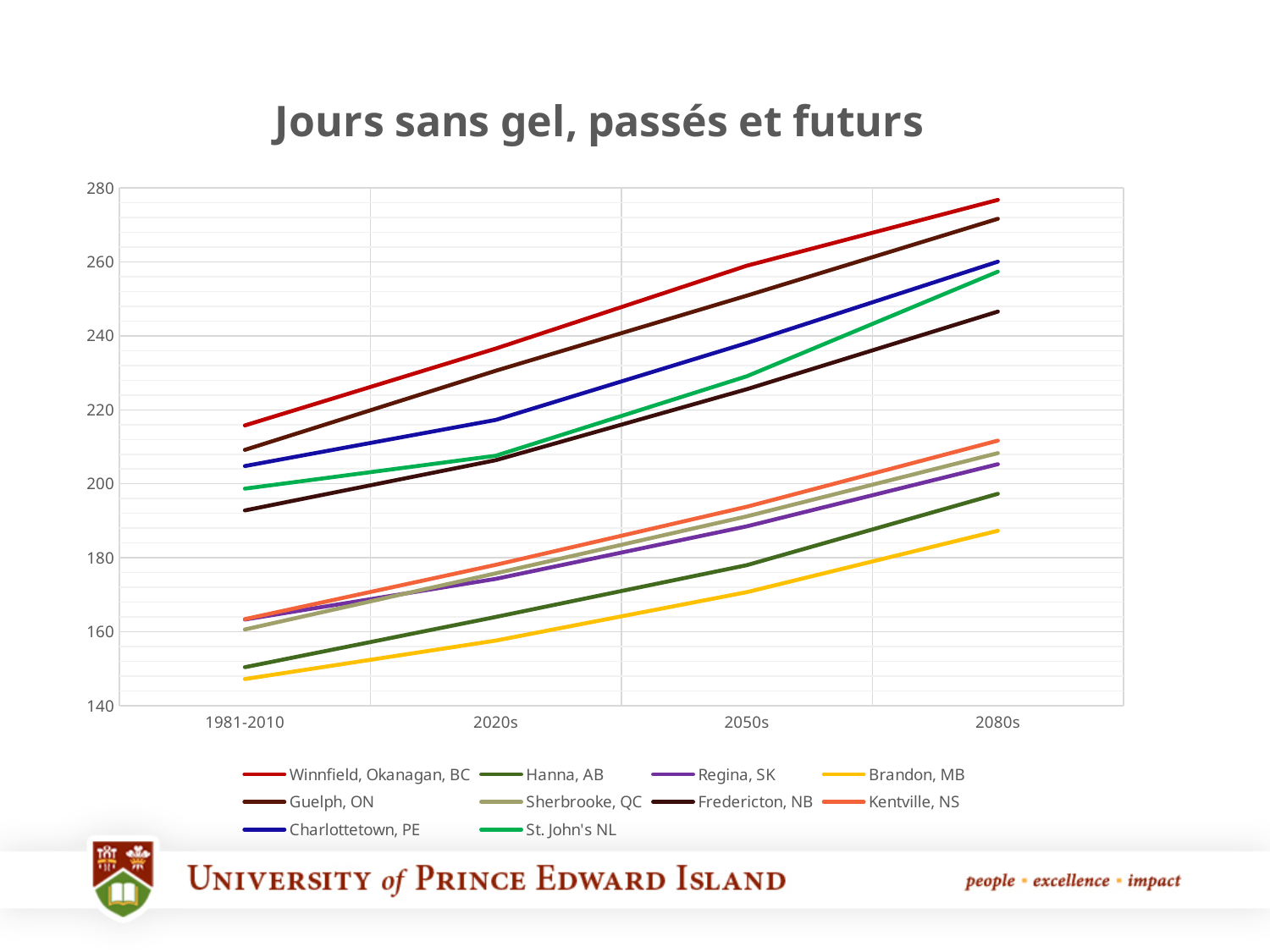
Do the values for Brandon, MB rise or fall from 1981-2010 to the 2080s? rise What is the title of the chart? Jours sans gel, passés et futurs What kind of chart is shown on the slide? line chart Is the value for Brandon, MB in 1981-2010 greater or less than 160? less Is the value for St. John's NL in the 2020s greater or less than 200? greater Is the value for Winnfield, Okanagan, BC in the 2080s greater or less than 260? greater How many time periods are shown on the x axis? 4 How many series does the legend list? 10 Which has the larger value in the 2080s, Kentville, NS or Brandon, MB? Kentville, NS Which has the larger value in the 2050s, Guelph, ON or Charlottetown, PE? Guelph, ON Which location has the highest value in the 2080s? Winnfield, Okanagan, BC Which location has the lowest value in the 2080s? Brandon, MB